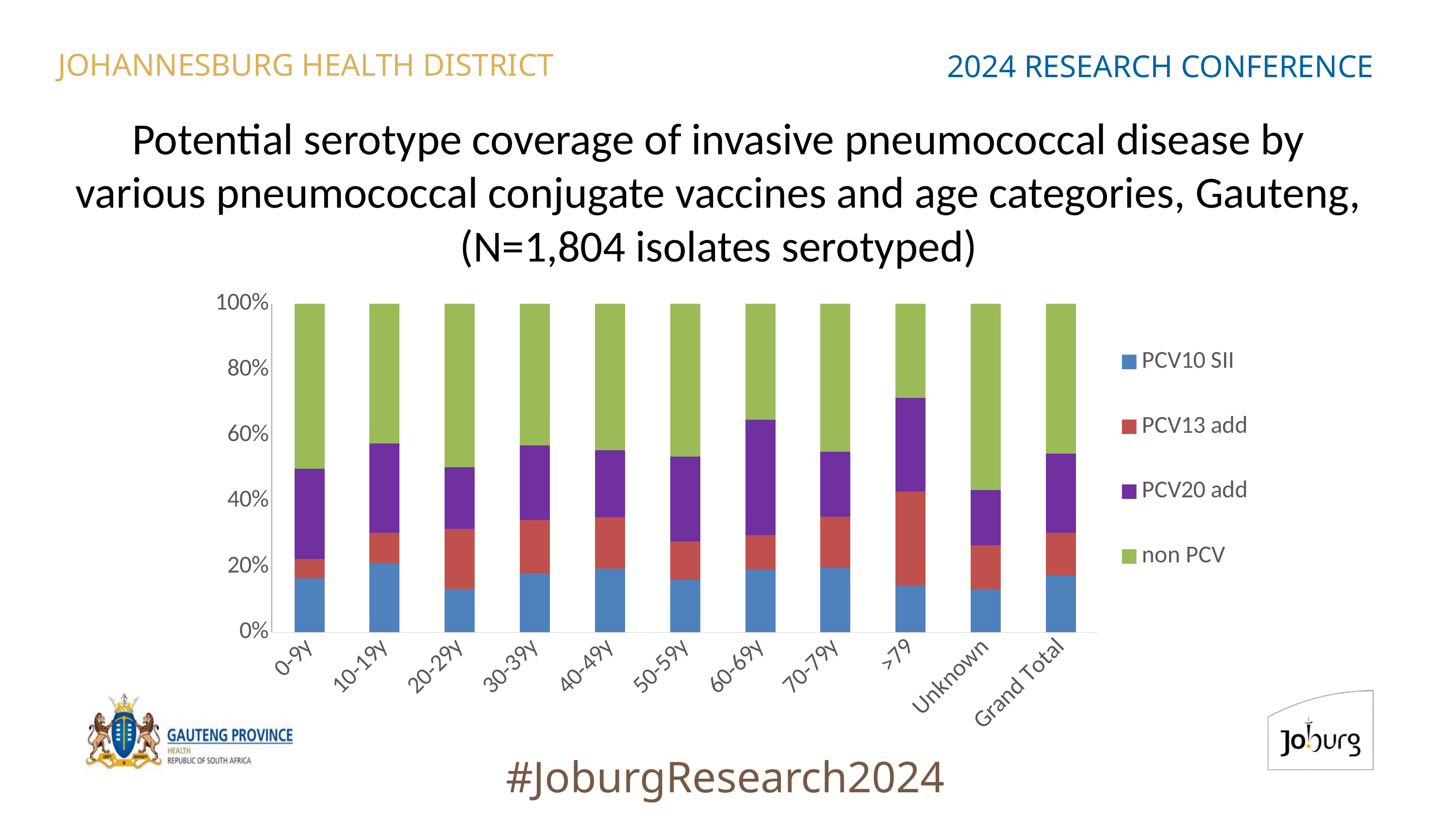
Is the PCV10 SII value for 0-9y greater or less than 20%? less Which is larger, the PCV13 add segment for >79 or for 0-9y? >79 How many categories are shown along the x axis of the chart? 11 How many series does the chart legend list? 4 Which category has the largest PCV20 add segment? 60-69y Which category has the largest non PCV segment? Unknown Which is larger, the non PCV segment for Unknown or for 60-69y? Unknown Which category has the smallest non PCV segment? >79 Which colour represents the non PCV series in the legend? Green Is the PCV10 SII value for Unknown greater or less than 20%? less What kind of chart is shown on the slide? Stacked bar chart Which category has the largest PCV13 add segment? >79